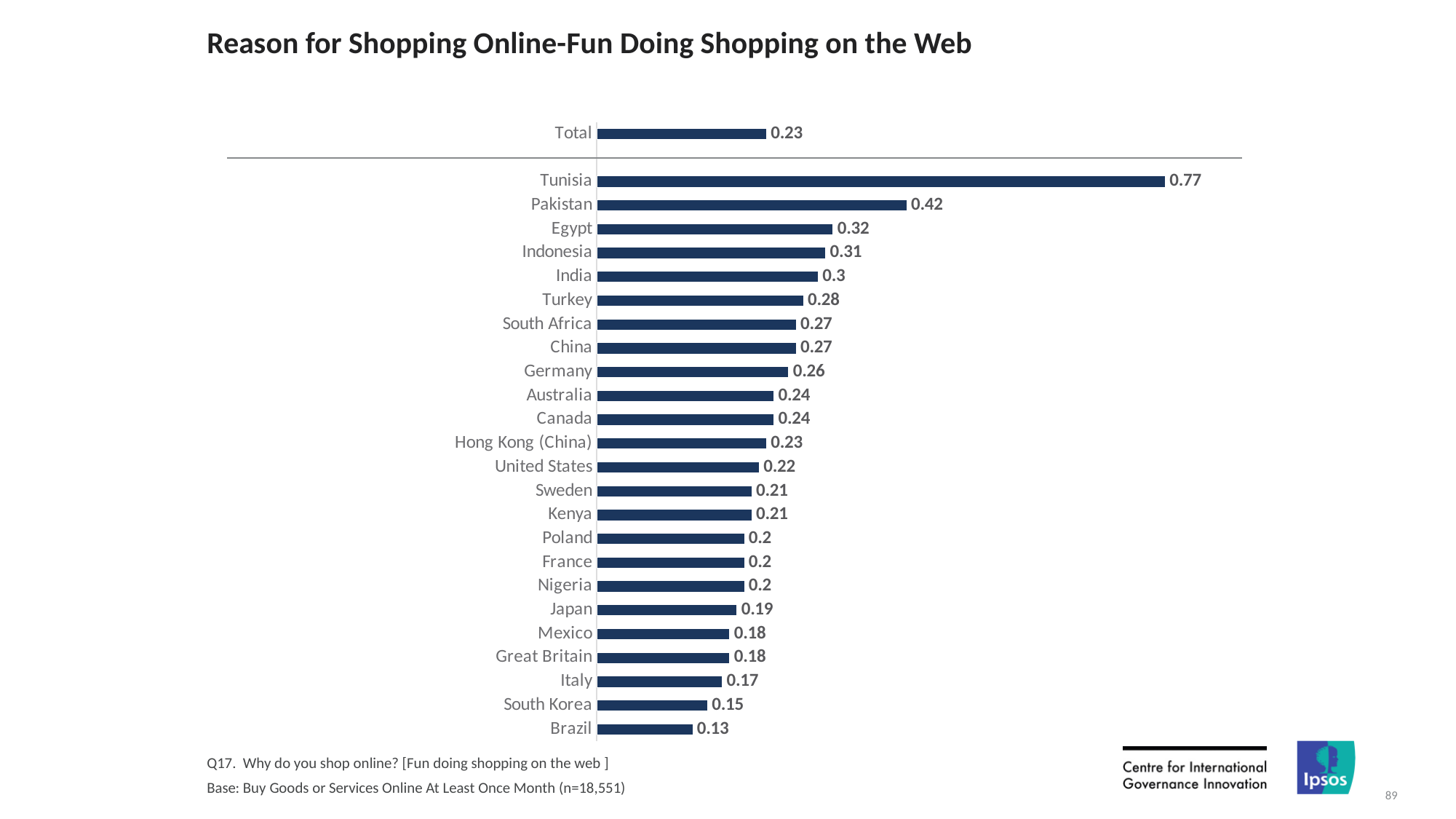
Which has a larger value, Japan or Italy? Japan Which country has the highest value? Tunisia What is the difference between the values for Tunisia and Pakistan? 0.35 What kind of chart is shown on the slide? Bar chart What is the value for Germany? 0.26 What is the value for Total? 0.23 How many countries are listed below the Total bar? 23 What is the value for Tunisia? 0.77 Which country has the lowest value? Brazil What is the value for Brazil? 0.13 Which has a larger value, Pakistan or Egypt? Pakistan What is the difference between the values for Egypt and Brazil? 0.19